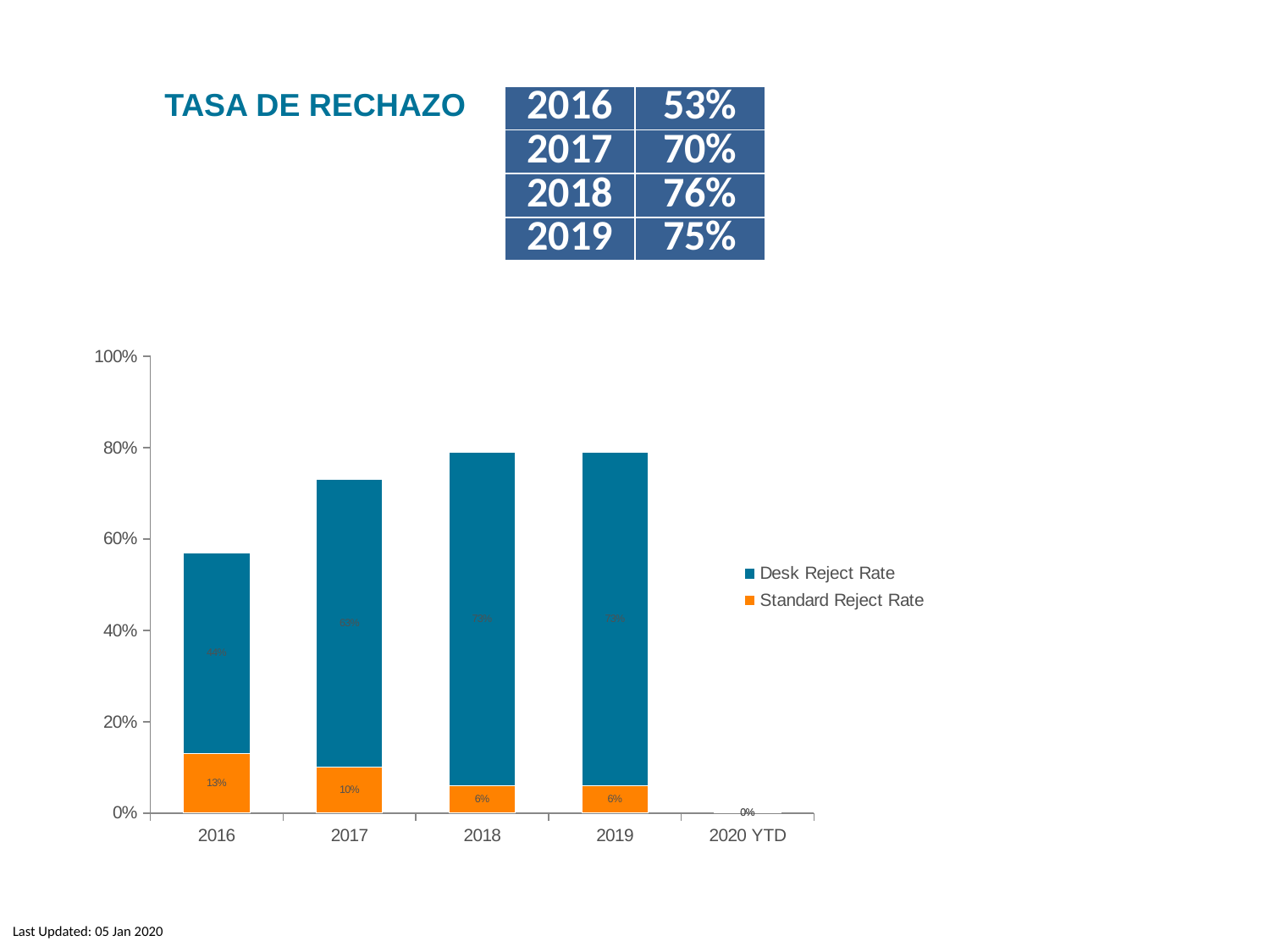
What is the difference between the Standard Reject Rate in 2016 and in 2017? 3% What value is labelled for 2020 YTD? 0% Does the Standard Reject Rate rise or fall from 2016 to 2019? fall What kind of chart is shown on the slide? stacked bar chart What is the Standard Reject Rate for 2016? 13% Which is larger, the Standard Reject Rate for 2016 or for 2018? 2016 Is the total height of the stacked bar for 2018 greater or less than 60%? greater What is the Standard Reject Rate for 2019? 6% What is the Standard Reject Rate for 2017? 10% How many categories are shown on the x axis? 5 How many series does the legend list? 2 Which year has the highest Standard Reject Rate? 2016